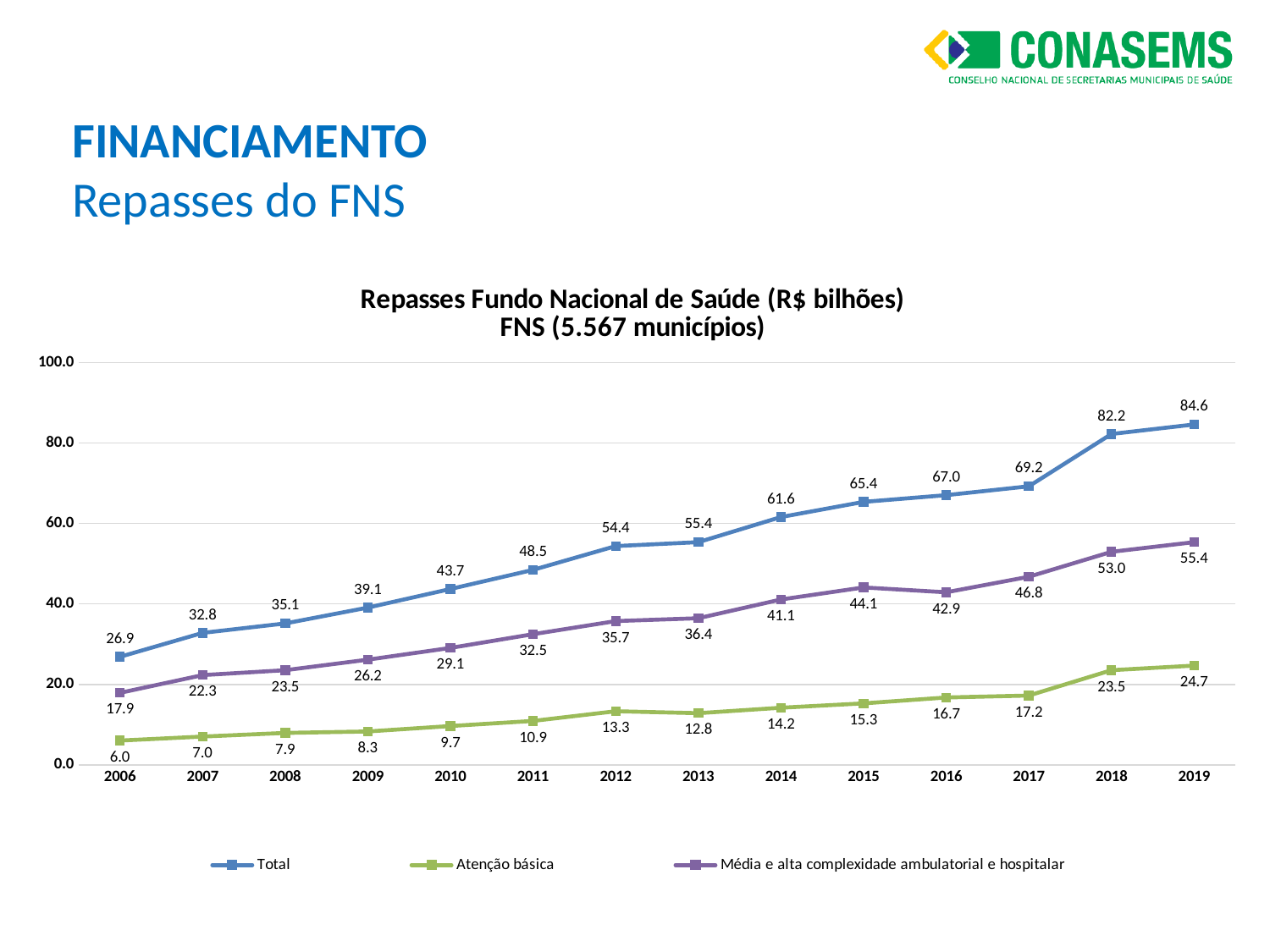
Does the Total series generally rise or fall from 2006 to 2019? rise What is the title of the chart? Repasses Fundo Nacional de Saúde (R$ bilhões) FNS (5.567 municípios) What is the difference between the Total values in 2019 and 2018? 2.4 What is the value of Média e alta complexidade ambulatorial e hospitalar in 2015? 44.1 Which is larger: Média e alta complexidade ambulatorial e hospitalar in 2016 or in 2015? 2015 What kind of chart is shown? line chart What is the value of Atenção básica in 2006? 6.0 What is the value of the Total series in 2019? 84.6 In which year is the Total series at its lowest? 2006 How many series does the legend list? 3 How many years are shown on the x axis? 14 In which year is the Atenção básica series at its highest? 2019